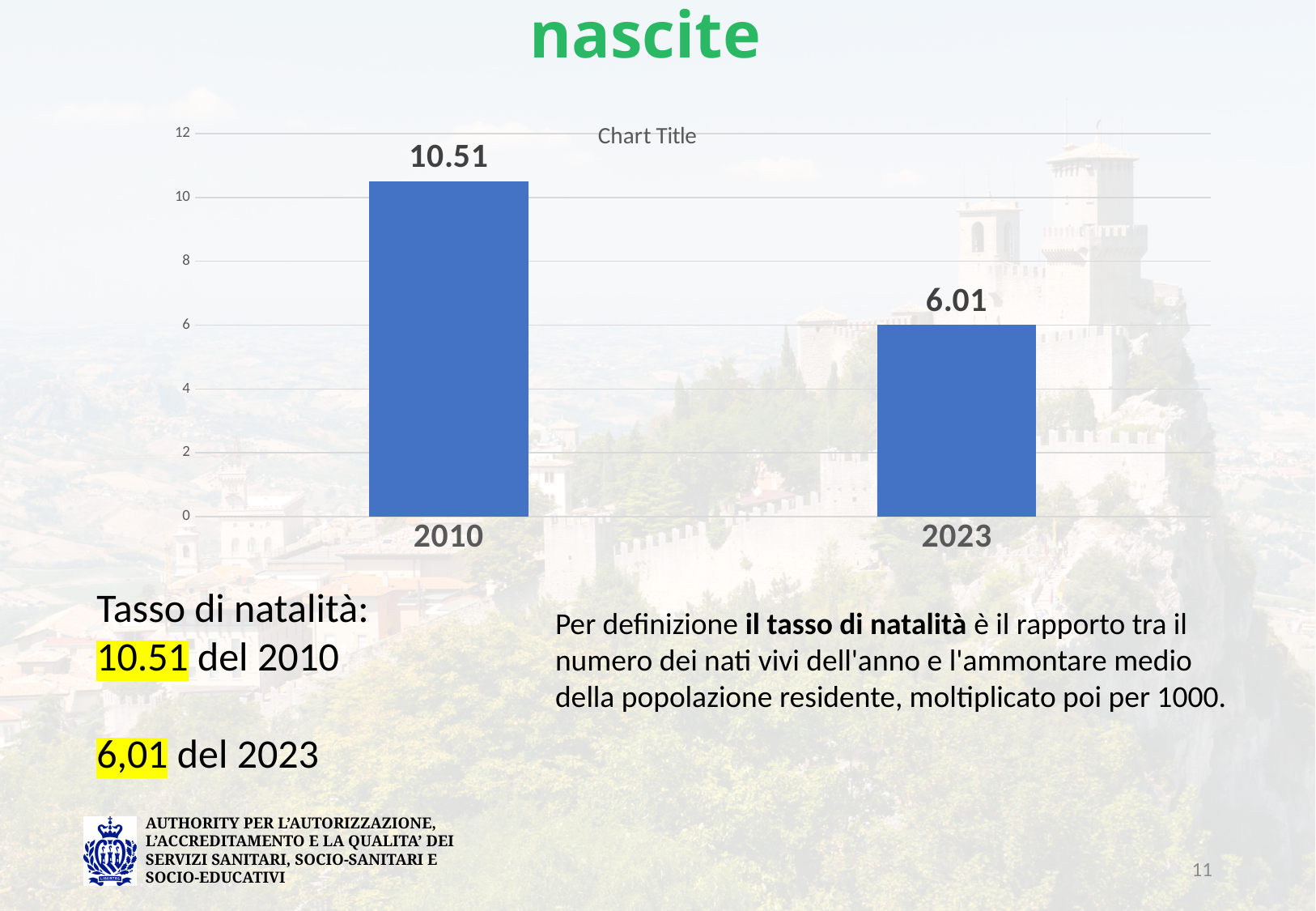
What is the value for 2010? 10.51 Which year has the lowest value? 2023 Which year has the highest value? 2010 Is the value for 2010 greater or less than 10? greater Which is larger, the value for 2010 or the value for 2023? 2010 What is the title printed inside the chart area? Chart Title What kind of chart is shown on the slide? bar chart How many bars are shown in the chart? 2 Do the values rise or fall from 2010 to 2023? fall What is the difference between the values for 2010 and 2023? 4.50 Is the value for 2023 greater or less than 8? less What is the value for 2023? 6.01